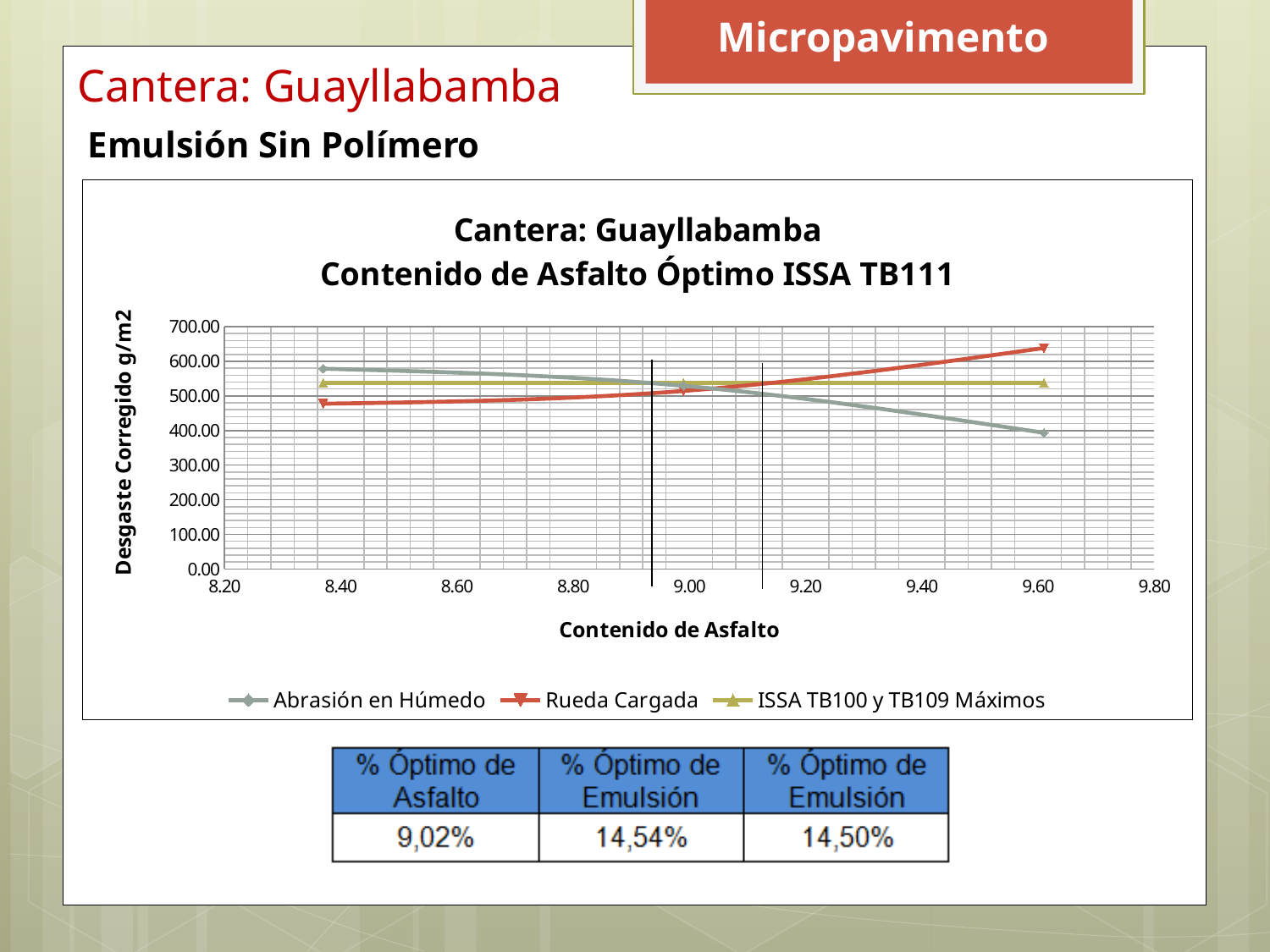
Is the value of Rueda Cargada at its last point (near 9.60) greater or less than 600? greater Does the Rueda Cargada line rise or fall as Contenido de Asfalto increases? rise Does the Abrasión en Húmedo line rise or fall as Contenido de Asfalto increases? fall At the first point (near 8.40), which series is higher: Abrasión en Húmedo or Rueda Cargada? Abrasión en Húmedo What kind of chart is shown on the slide? line chart How many series does the legend of the chart list? 3 At the last point (near 9.60), which series is higher: Rueda Cargada or Abrasión en Húmedo? Rueda Cargada Is the value of Abrasión en Húmedo at its first point (near 8.40) greater or less than 500? greater What is the title of the y axis of the chart? Desgaste Corregido g/m2 Is the ISSA TB100 y TB109 Máximos line above or below 500 on the y axis? above How many data points does the Rueda Cargada series have? 3